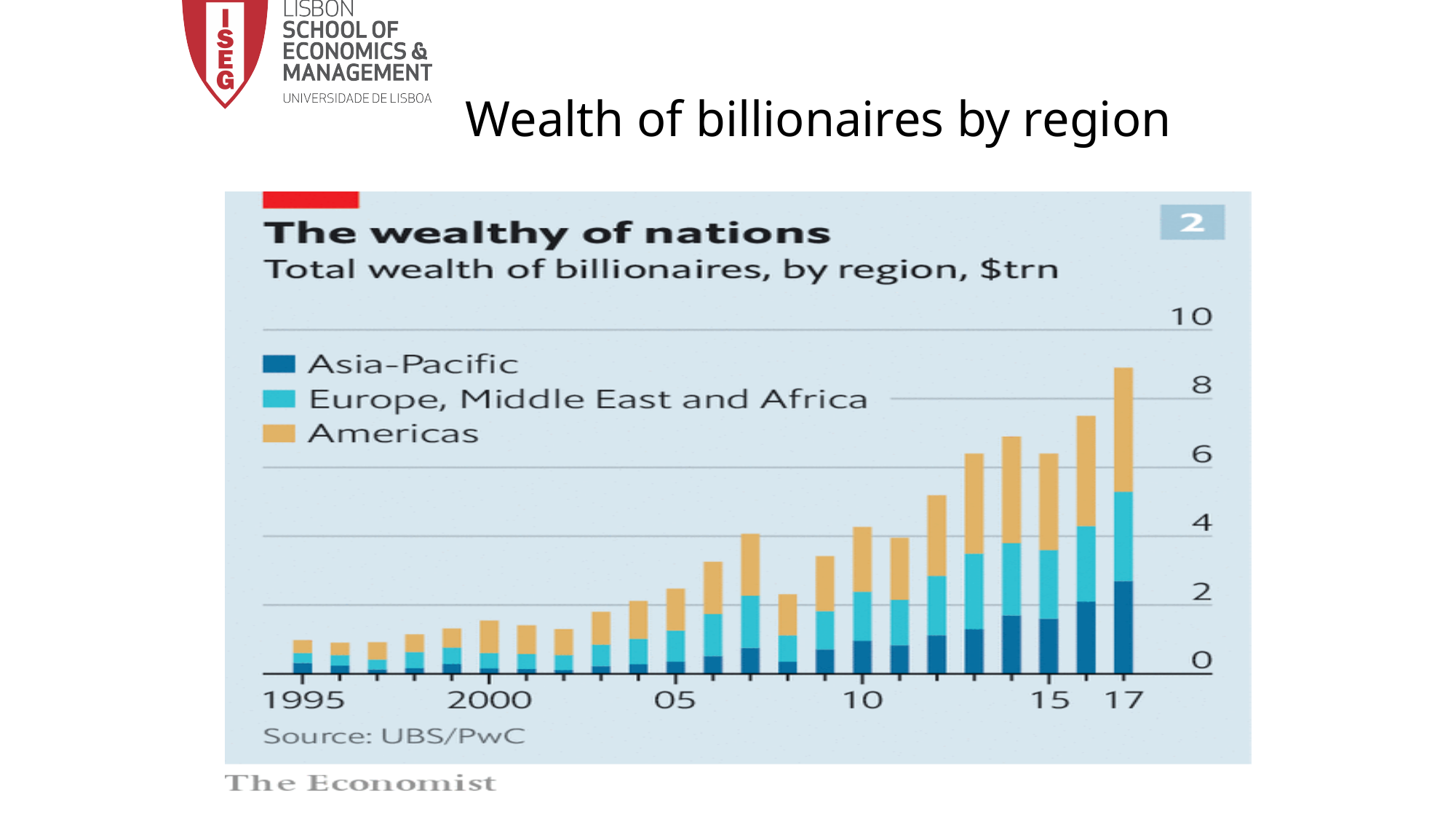
What kind of chart is shown on the slide? Stacked bar chart Which year has the larger total wealth of billionaires, 2014 or 2015? 2014 Which year has the larger total wealth of billionaires, 2007 or 2008? 2007 Which year has the highest total wealth of billionaires? 2017 Which regions are listed in the legend? Asia-Pacific; Europe, Middle East and Africa; Americas What is the title of the chart? The wealthy of nations Is the total wealth of billionaires in 2017 greater or less than 8 $trn? greater How many years (bars) are plotted in the chart? 23 Is the total wealth of billionaires in 2014 greater or less than 6 $trn? greater Overall, does the total wealth of billionaires rise or fall from 1995 to 2017? Rise Is the total wealth of billionaires in 2005 greater or less than 4 $trn? less How many series does the legend list? 3